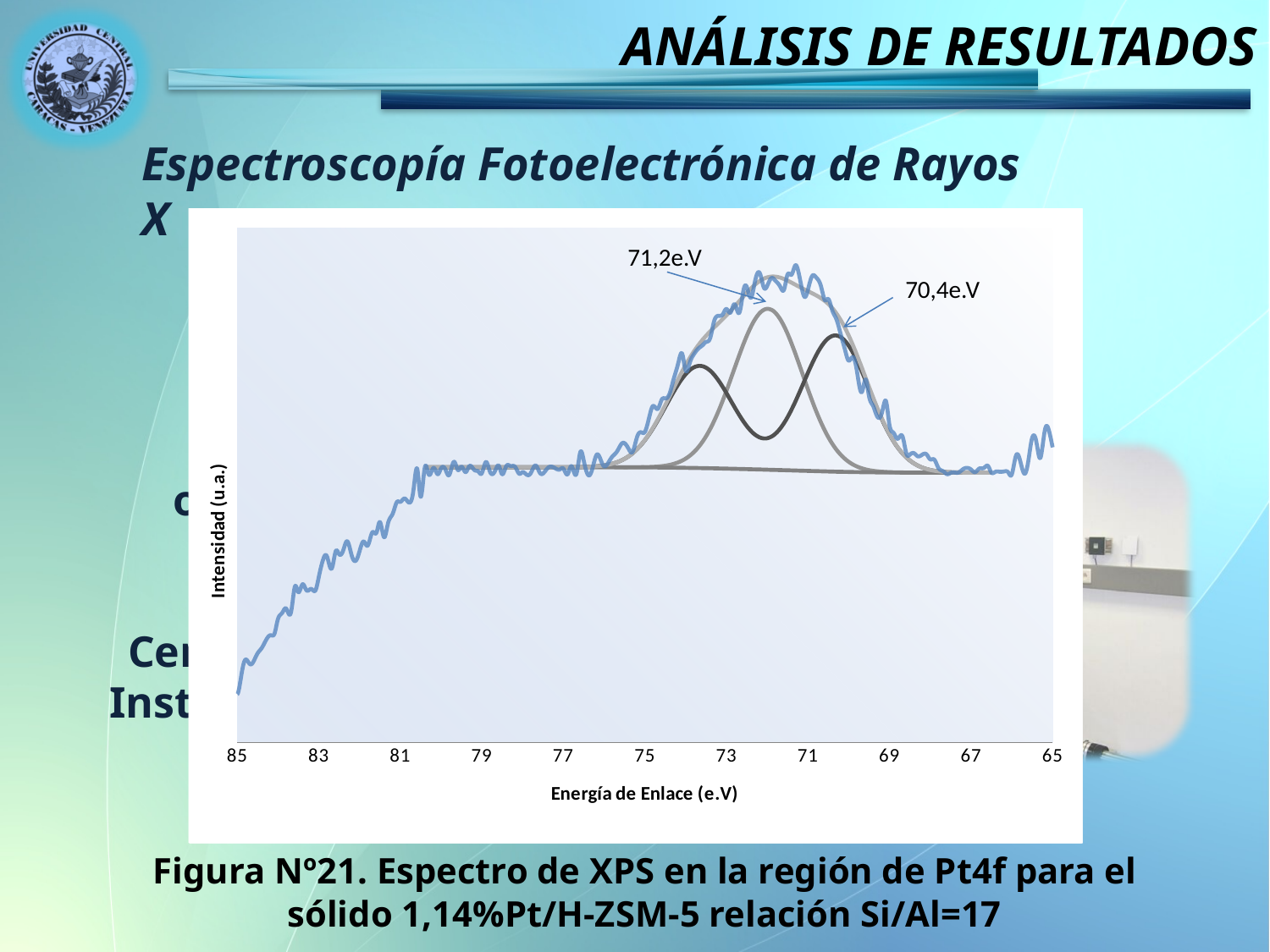
What is the rightmost tick value on the x axis? 65 How many tick labels are shown on the x axis of the chart? 11 Of the two annotated binding energies, which is larger? 71,2e.V What is the title of the y axis of the chart? Intensidad (u.a.) What binding energy value is annotated at the right-hand fitted peak of the spectrum? 70,4e.V Moving from 85 to 81 on the x axis, does the blue spectrum line rise or fall? rise What binding energy value is annotated at the central fitted peak of the spectrum? 71,2e.V Which is higher on the chart: the blue line near x = 72 or the blue line near x = 79? near x = 72 What is the title of the x axis of the chart? Energía de Enlace (e.V) What is the leftmost tick value on the x axis? 85 What kind of chart is shown on the slide? line chart